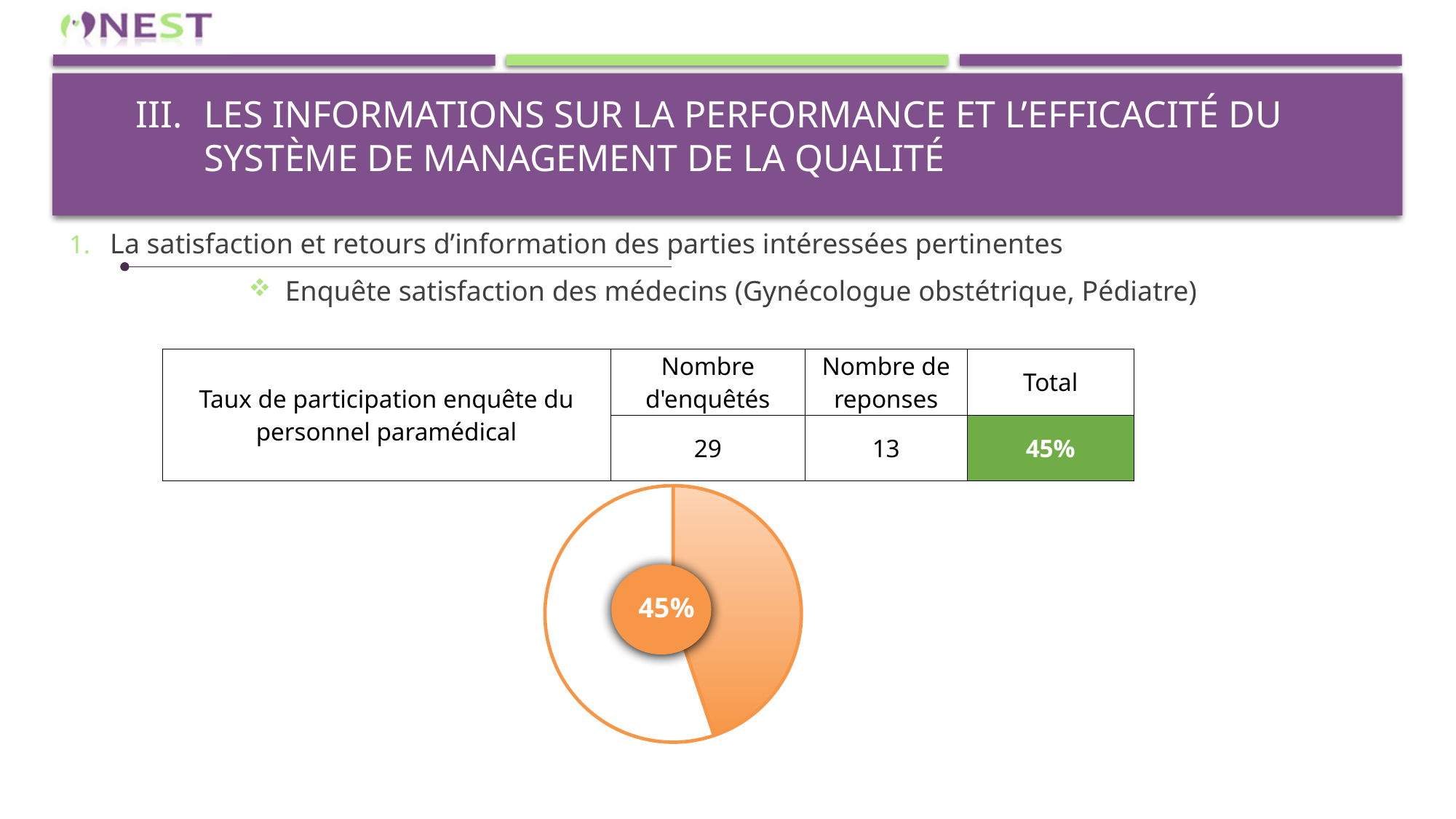
How many slices does the pie chart have? 2 Where is the 45% data label placed on the pie chart? in the centre of the pie What kind of chart is shown on the slide? pie chart What share of the pie does the orange (coloured) slice represent? 45% What colour is the labelled slice of the pie chart? orange Which slice of the pie chart is larger, the orange slice or the white slice? the white slice What value is printed on the pie chart? 45% Is the labelled slice of the pie chart greater or less than 50%? less